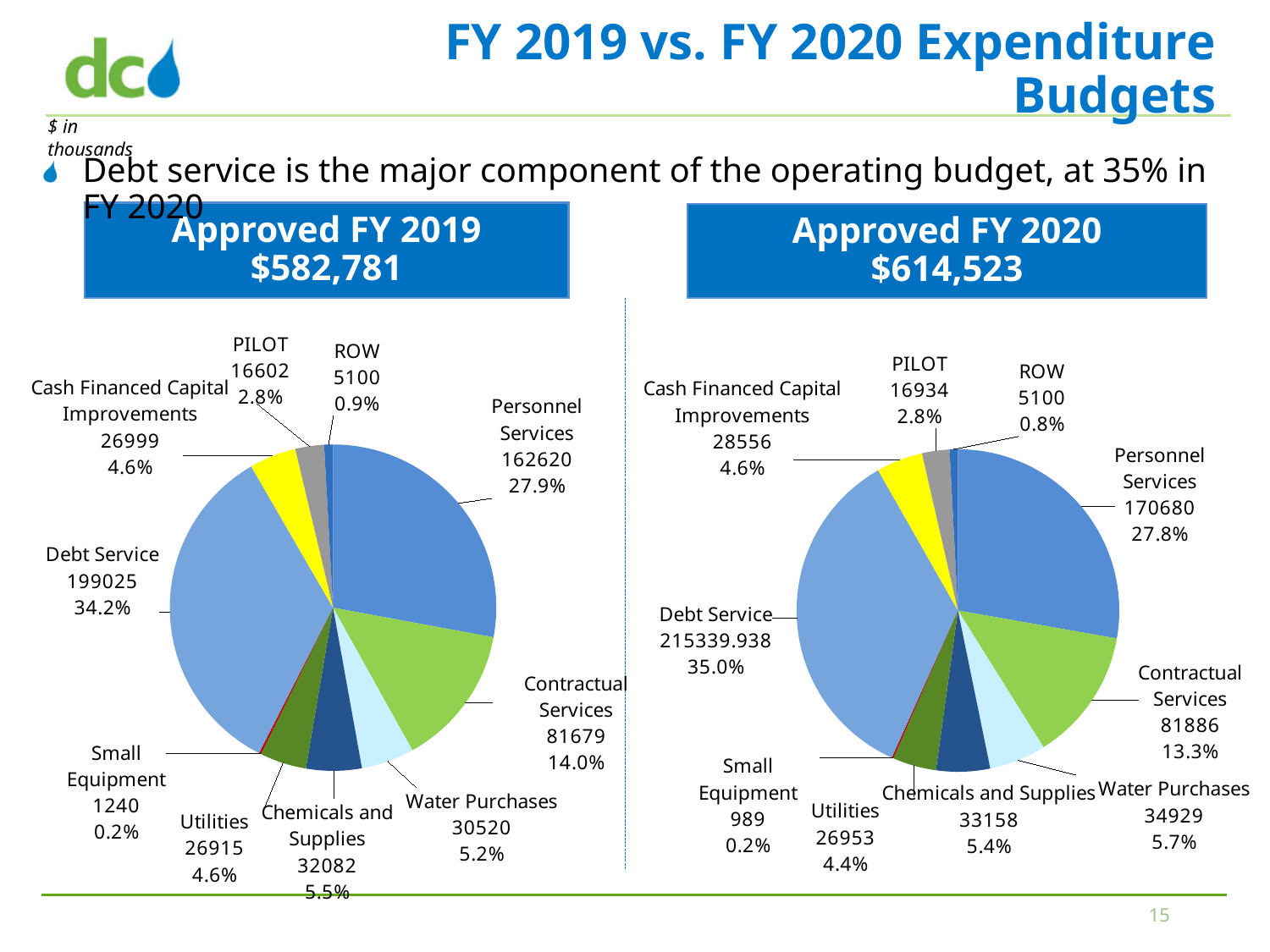
What type of chart is used for the Approved FY 2020 budget? Pie chart In the Approved FY 2020 pie chart, what is the value for Personnel Services? 170680 In the Approved FY 2019 pie chart, what is the difference between Contractual Services and Water Purchases? 51159 In the Approved FY 2019 pie chart, which category has the largest slice? Debt Service In the Approved FY 2019 pie chart, what is the value for Debt Service? 199025 In the Approved FY 2020 pie chart, what is the value for Utilities? 26953 What total is shown in the title of the Approved FY 2020 chart? $614,523 In the Approved FY 2019 pie chart, what share of the pie is Contractual Services? 14.0% In the Approved FY 2020 pie chart, which category has the smallest slice? Small Equipment How many categories are shown in the Approved FY 2019 pie chart? 10 In the Approved FY 2020 pie chart, what share of the pie is Debt Service? 35.0% In the Approved FY 2020 pie chart, which is larger, Water Purchases or Chemicals and Supplies? Water Purchases